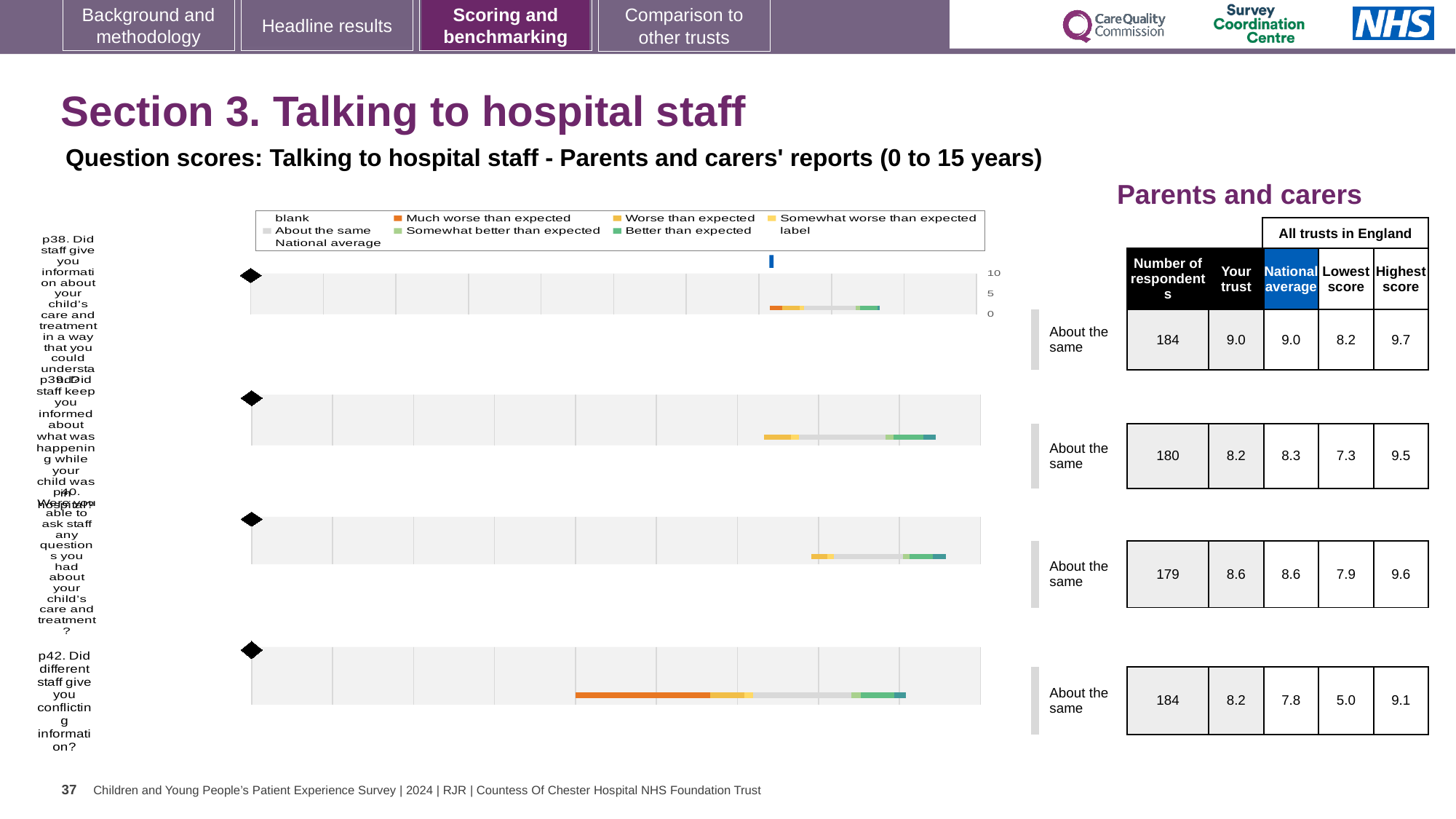
What is the 'Your trust' score for p39 (Did staff keep you informed about what was happening while your child was in hospital?)? 8.2 Which question has the highest 'Highest score' value in the table? p38 (9.7) For p38 (Did staff give you information about your child's care and treatment in a way that you could understand?), how many respondents are shown? 184 For p42, what is the difference between the 'Your trust' score and the National average? 0.4 What is the National average score for p42 (Did different staff give you conflicting information?)? 7.8 Which question has the lowest 'Lowest score' value in the table? p42 (5.0) For p39, which is larger: the 'Your trust' score or the National average? National average What kind of chart is used to show the question scores on this slide? Bar chart In the legend, what colour represents 'Much worse than expected'? Orange What benchmark category label is shown next to each of the four question charts? About the same What is the Lowest score across all trusts in England for p42? 5.0 How many survey questions (p38, p39, p40, p42) are plotted on the slide? 4